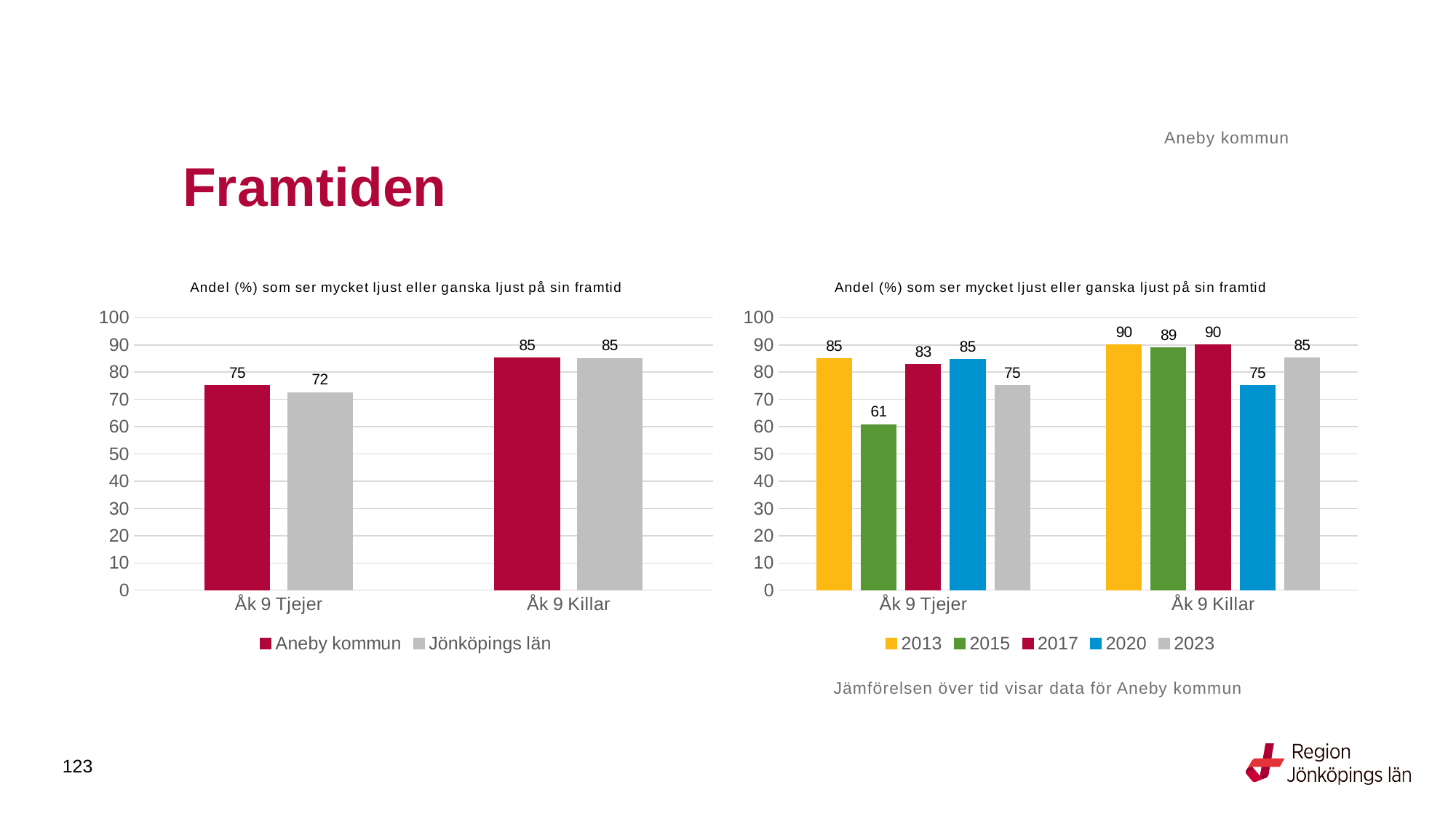
In the left chart, what is the value for Aneby kommun for Åk 9 Tjejer? 75 In the right chart, how many series does the legend list? 5 In the right chart, which year has the lowest value for Åk 9 Killar? 2020 In the left chart, what is the difference between Aneby kommun and Jönköpings län for Åk 9 Tjejer? 3 In the right chart, what is the value for 2015 for Åk 9 Tjejer? 61 In the right chart, which year has the lowest value for Åk 9 Tjejer? 2015 In the left chart, how many series does the legend list? 2 What kind of chart is the left chart? bar chart In the left chart, what is the value for Jönköpings län for Åk 9 Killar? 85 In the right chart, what is the difference between the 2013 and 2015 values for Åk 9 Tjejer? 24 In the right chart, what is the value for 2020 for Åk 9 Killar? 75 In the right chart, is the 2023 value for Åk 9 Killar larger or smaller than the 2023 value for Åk 9 Tjejer? larger